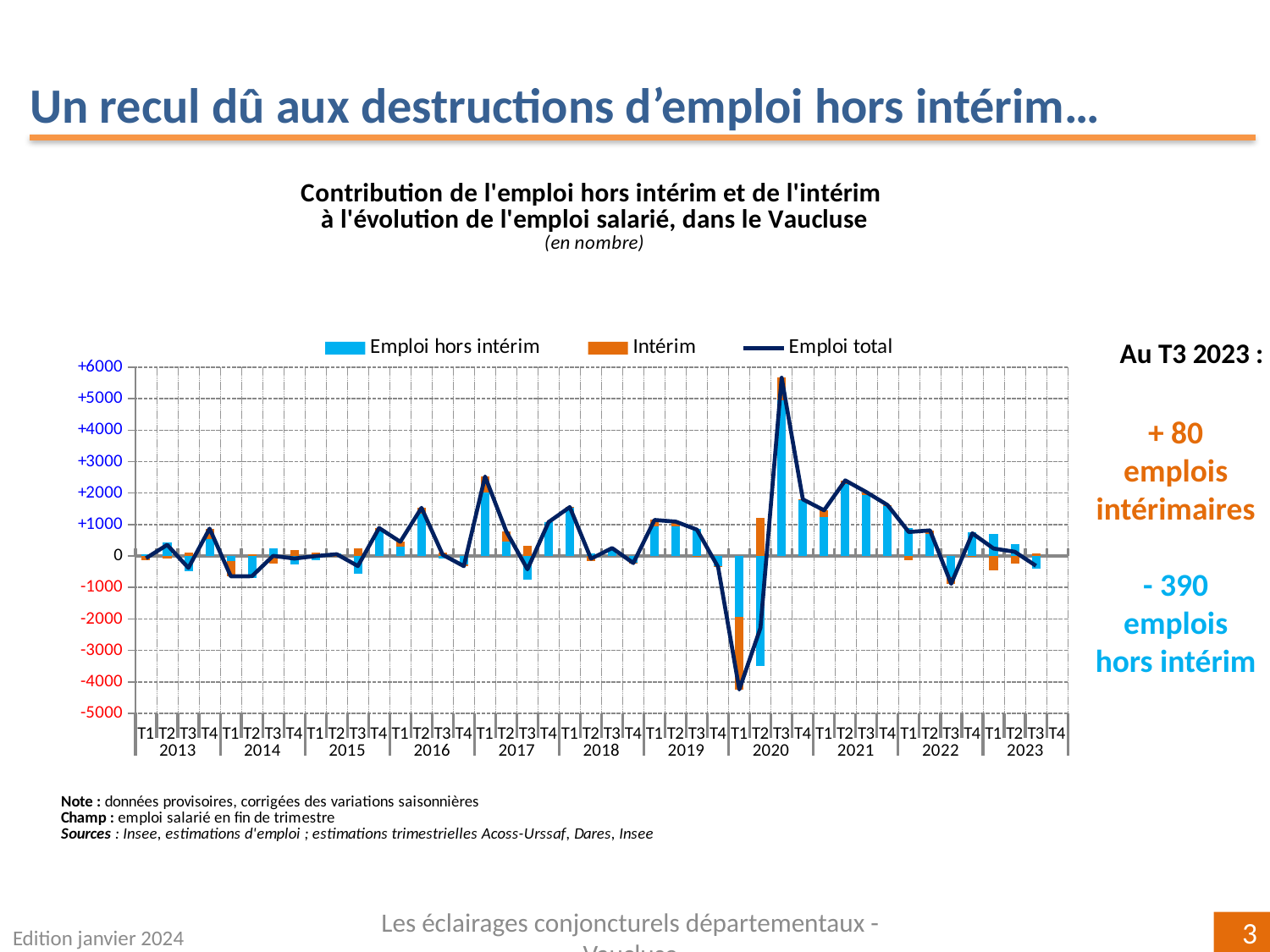
Is the Emploi total value at T1 2020 greater or less than -4000? less According to the annotation on the slide, what is the contribution of emplois hors intérim at T3 2023? - 390 How many years are labelled along the x axis of the chart? 11 What kind of chart is shown on the slide? bar and line chart In which quarter does the Emploi total line reach its highest value? T3 2020 Which colour represents the Intérim series in the chart? orange According to the annotation on the slide, what is the contribution of emplois intérimaires at T3 2023? + 80 In which quarter does the Emploi total line reach its lowest value? T1 2020 Is the Emploi total value at T3 2020 greater or less than +5000? greater What are the three series named in the chart legend? Emploi hors intérim, Intérim, Emploi total How many series does the chart legend list? 3 Which is larger, the Emploi hors intérim bar at T3 2020 or at T4 2020? T3 2020